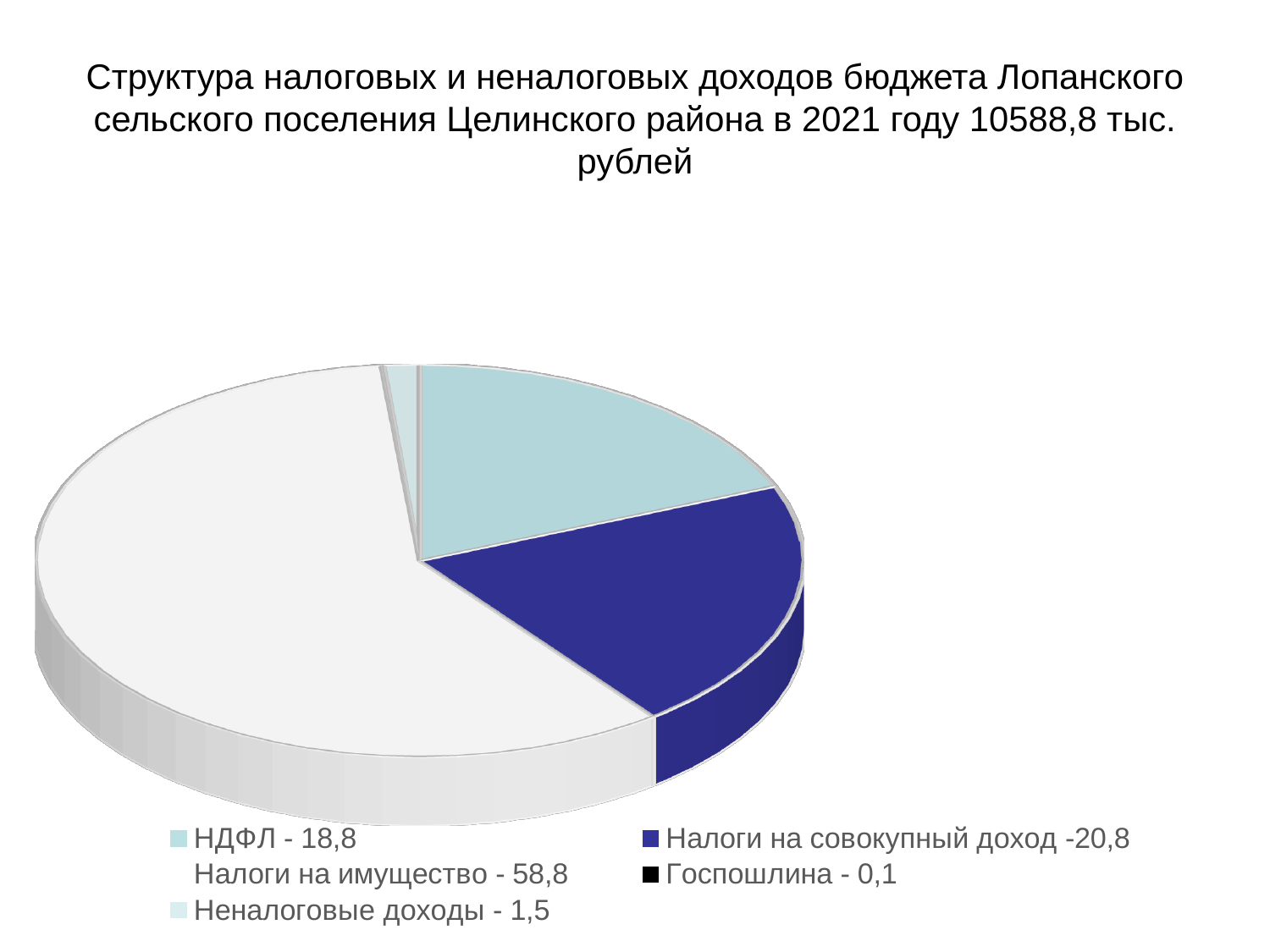
What value is given for Налоги на совокупный доход in the legend? 20,8 Which category has the smallest value in the pie chart? Госпошлина What value is given for Неналоговые доходы in the legend? 1,5 Which category has the largest slice of the pie? Налоги на имущество What value is given for Налоги на имущество in the legend? 58,8 What value is given for Госпошлина in the legend? 0,1 Which is larger: Налоги на совокупный доход or НДФЛ? Налоги на совокупный доход What kind of chart is shown on the slide? pie chart What year does the chart title say the budget revenue structure refers to? 2021 What value is given for НДФЛ in the legend? 18,8 How many categories does the pie chart's legend list? 5 What is the difference between the values for Налоги на имущество and НДФЛ? 40,0